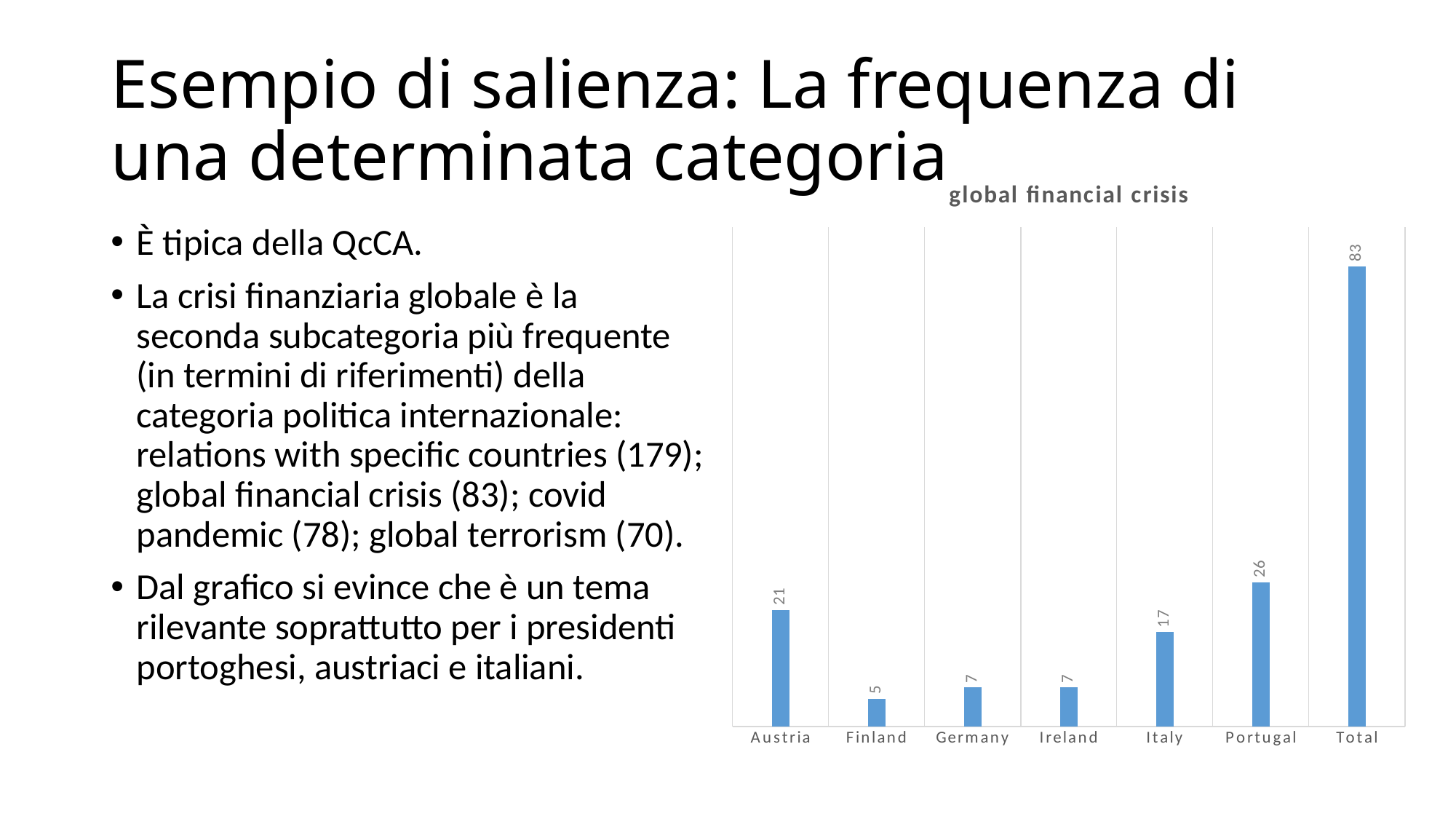
Which category has the lowest value? Finland What is the value for Finland? 5 What is the difference between the values for Total and Portugal? 57 What kind of chart is shown on the slide? Bar chart What is the title of the chart? global financial crisis Excluding the Total bar, which country has the highest value? Portugal What is the value for Total? 83 Which is larger, the value for Austria or the value for Italy? Austria What is the value for Portugal? 26 How many bars are shown in the chart? 7 What is the value for Austria? 21 What is the difference between the values for Portugal and Italy? 9